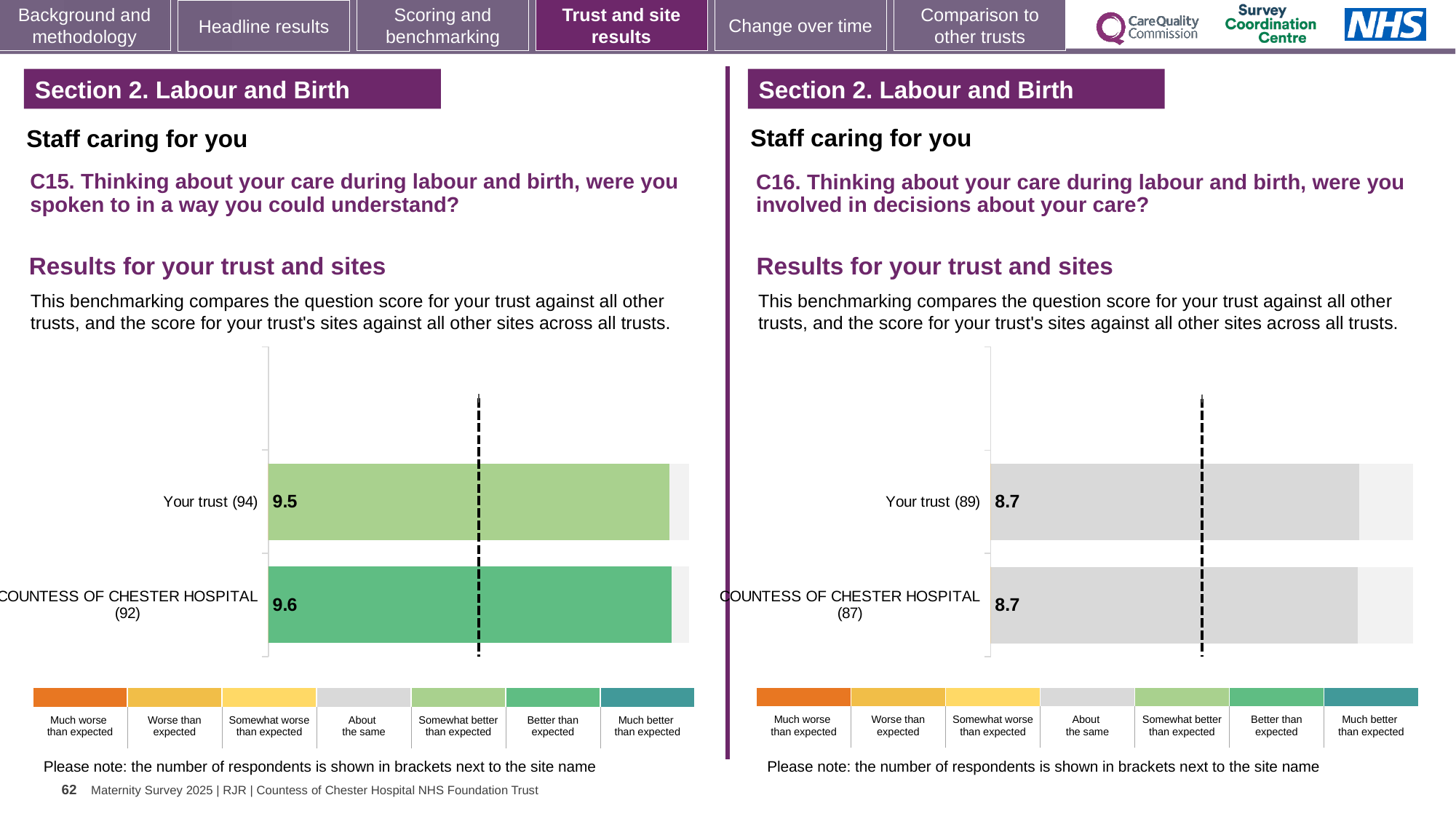
On the C15 chart (left), what is the score for Countess of Chester Hospital? 9.6 On the C16 chart (right), what is the score for Your trust? 8.7 How many bars are plotted on the C15 chart (left)? 2 On the C15 chart (left), what is the score for Your trust? 9.5 On the C16 chart (right), what is the score for Countess of Chester Hospital? 8.7 On the C15 chart (left), which has the higher score, Your trust or Countess of Chester Hospital? Countess of Chester Hospital What type of chart is used on the C15 chart (left)? Bar chart On the C15 chart (left), how many respondents are shown in brackets for Your trust? 94 On the C16 chart (right), what is the difference between the Your trust score and the Countess of Chester Hospital score? 0 On the C15 chart (left), what is the difference between the Countess of Chester Hospital score and the Your trust score? 0.1 How many bars are plotted on the C16 chart (right)? 2 On the C16 chart (right), which benchmark category does the colour of the Your trust bar correspond to in the legend? About the same